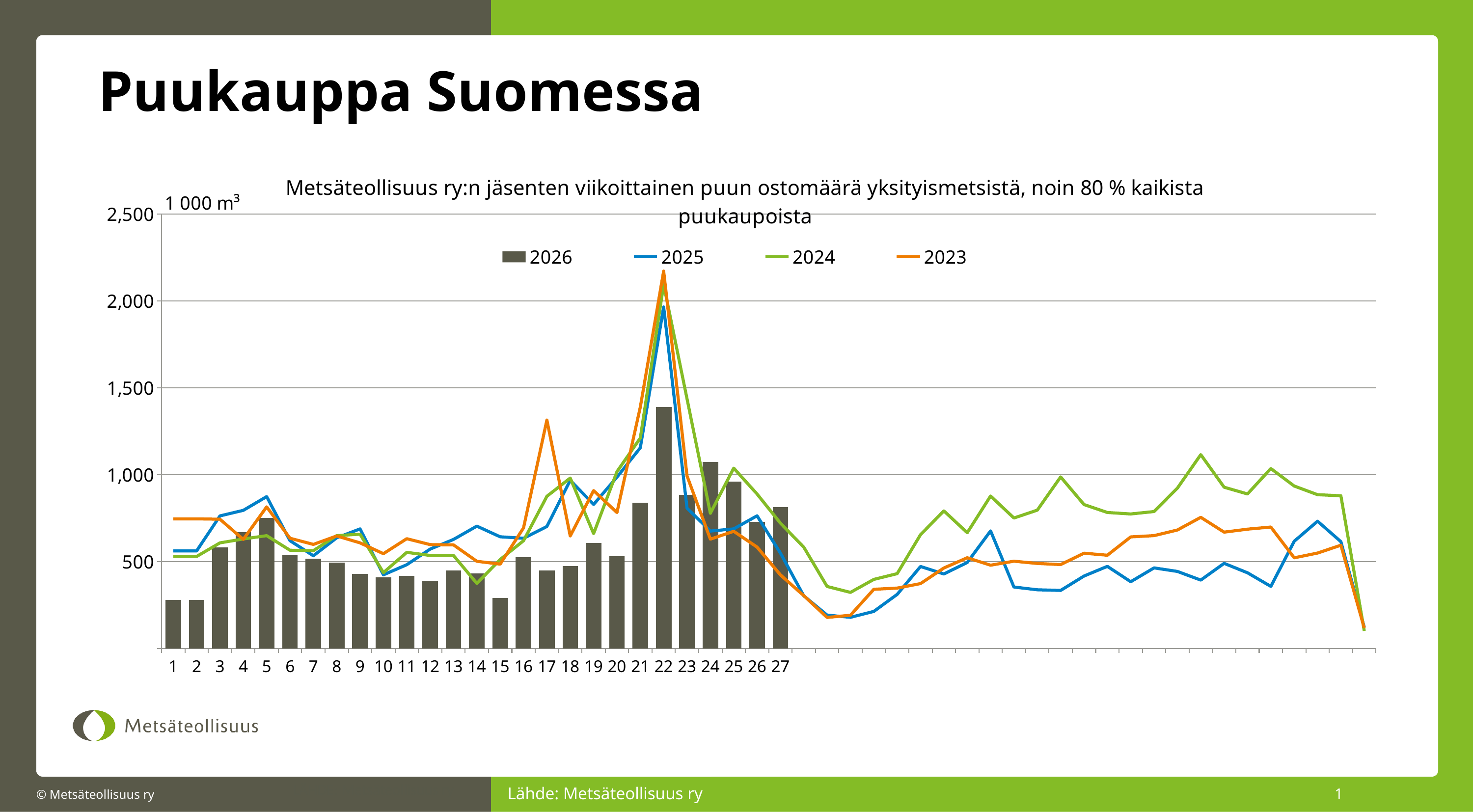
Which series is plotted as bars rather than lines? 2026 Is the 2023 value at week 22 greater or less than 2,000? greater What unit label is shown above the vertical axis? 1 000 m³ In which week is the 2026 bar highest? 22 Is the 2026 value for week 22 greater or less than 1,000? greater What kind of chart is shown on the slide? A combined bar and line chart Is the 2026 value for week 1 greater or less than 500? less How many weeks have a 2026 bar plotted? 27 Do the 2026 bars rise or fall from week 22 to week 27? Fall Which is larger for 2026: the bar for week 22 or the bar for week 23? Week 22 How many series does the chart legend list? 4